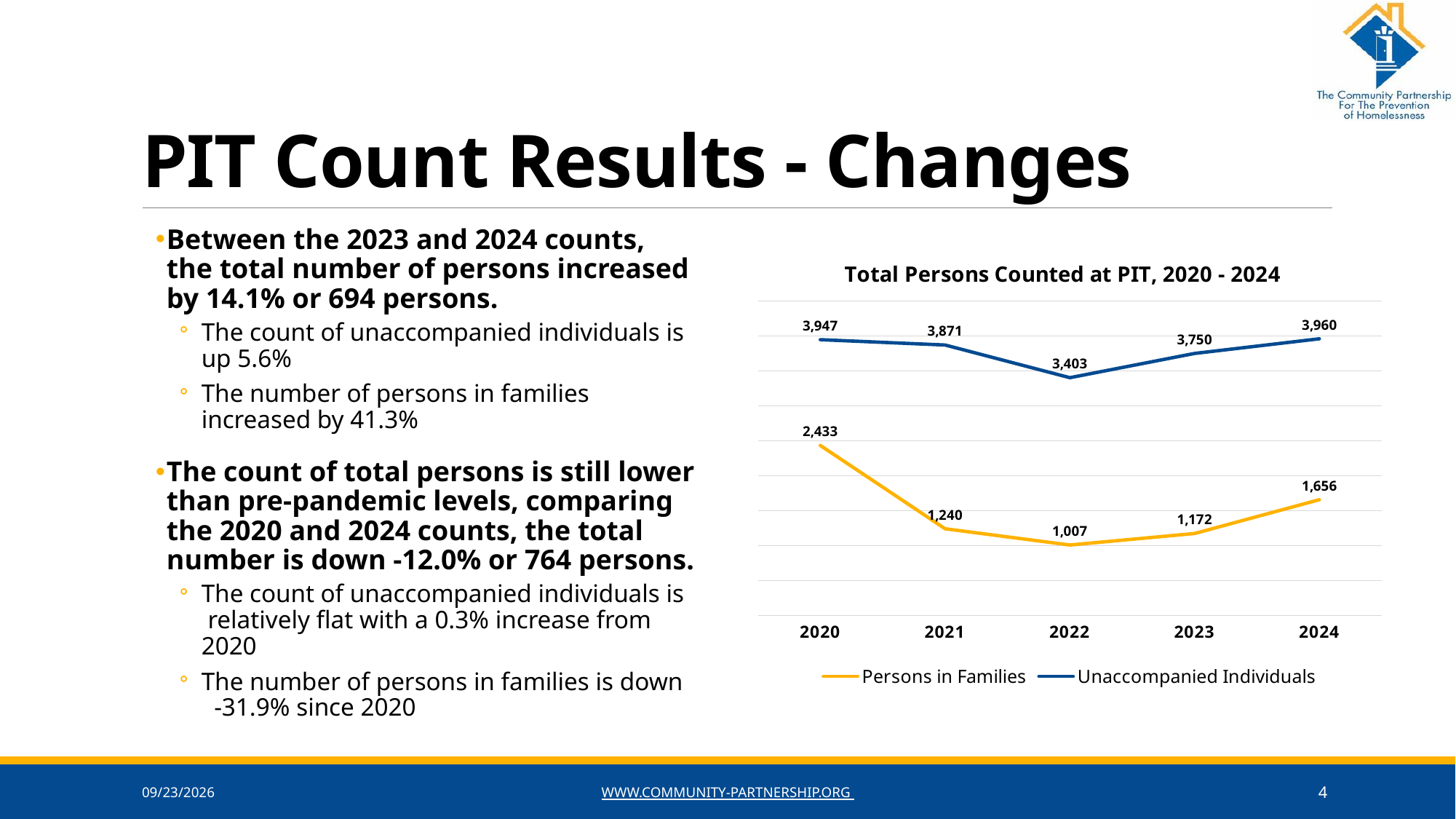
How many series does the legend list? 2 What is the value for Persons in Families in 2024? 1,656 What is the value for Unaccompanied Individuals in 2022? 3,403 What is the title of the chart? Total Persons Counted at PIT, 2020 - 2024 In which year is the Persons in Families count lowest? 2022 What kind of chart is shown? Line chart In which year is the Unaccompanied Individuals count highest? 2024 What is the value for Persons in Families in 2020? 2,433 What is the difference between the Persons in Families counts in 2020 and 2024? 777 Which is larger, the Persons in Families count in 2021 or in 2023? 2021 How many years are plotted on the x axis? 5 What is the difference between the Unaccompanied Individuals counts in 2024 and 2023? 210